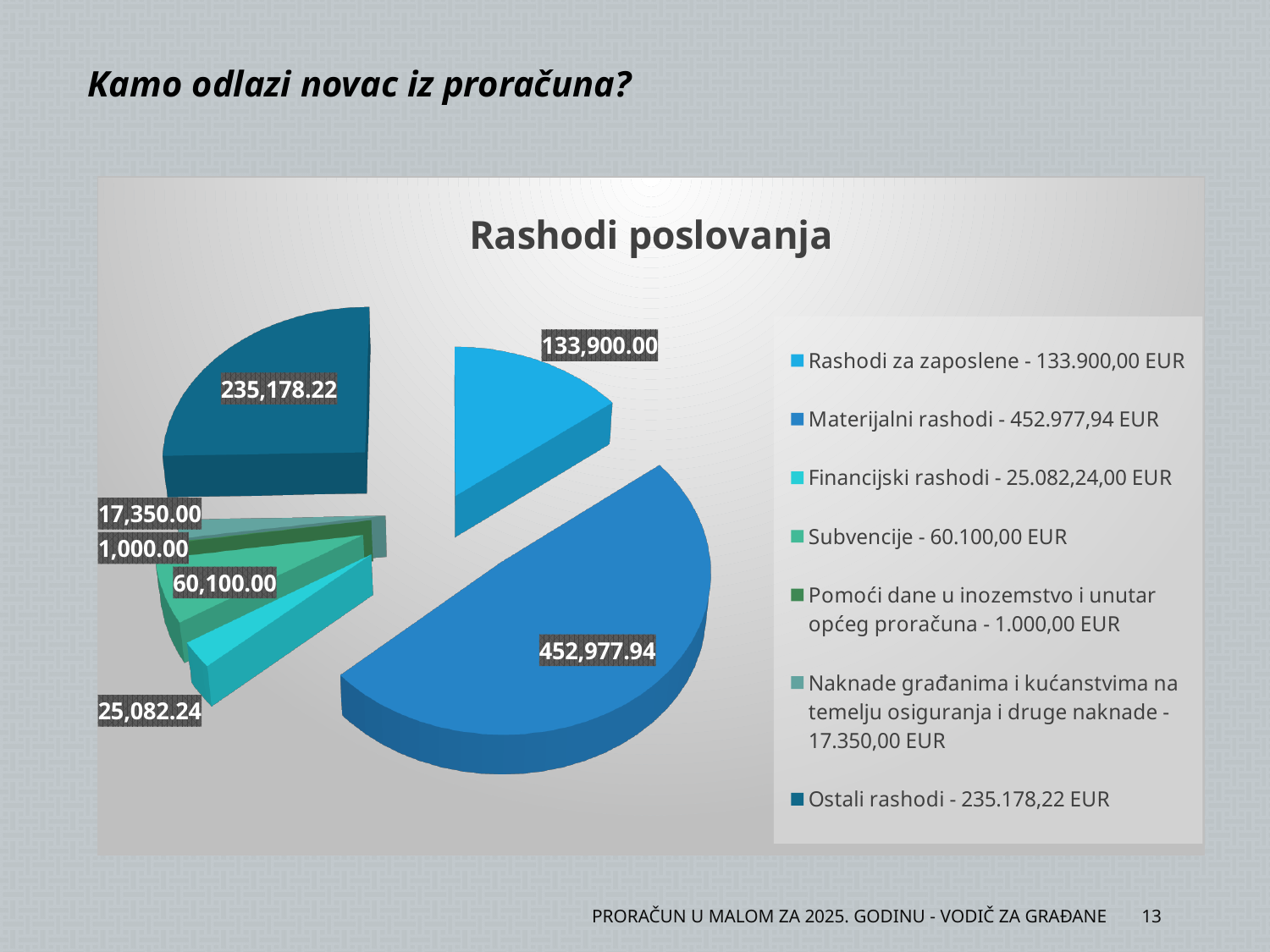
Which is larger, Financijski rashodi or Naknade građanima i kućanstvima na temelju osiguranja i druge naknade? Financijski rashodi Which category has the largest slice in the Rashodi poslovanja pie chart? Materijalni rashodi What value is shown for Ostali rashodi in the chart? 235,178.22 What value is shown for Rashodi za zaposlene in the pie chart? 133,900.00 What type of chart is shown on the slide? Pie chart What is the difference between Ostali rashodi and Subvencije? 175,078.22 Which category has the smallest slice in the pie chart? Pomoći dane u inozemstvo i unutar općeg proračuna What is the value of the Materijalni rashodi slice in the Rashodi poslovanja chart? 452,977.94 How many slices does the Rashodi poslovanja pie chart have? 7 What is the data label on the Subvencije slice? 60,100.00 What is the difference between the Materijalni rashodi value and the Rashodi za zaposlene value? 319,077.94 What is the title of the chart on the slide? Rashodi poslovanja